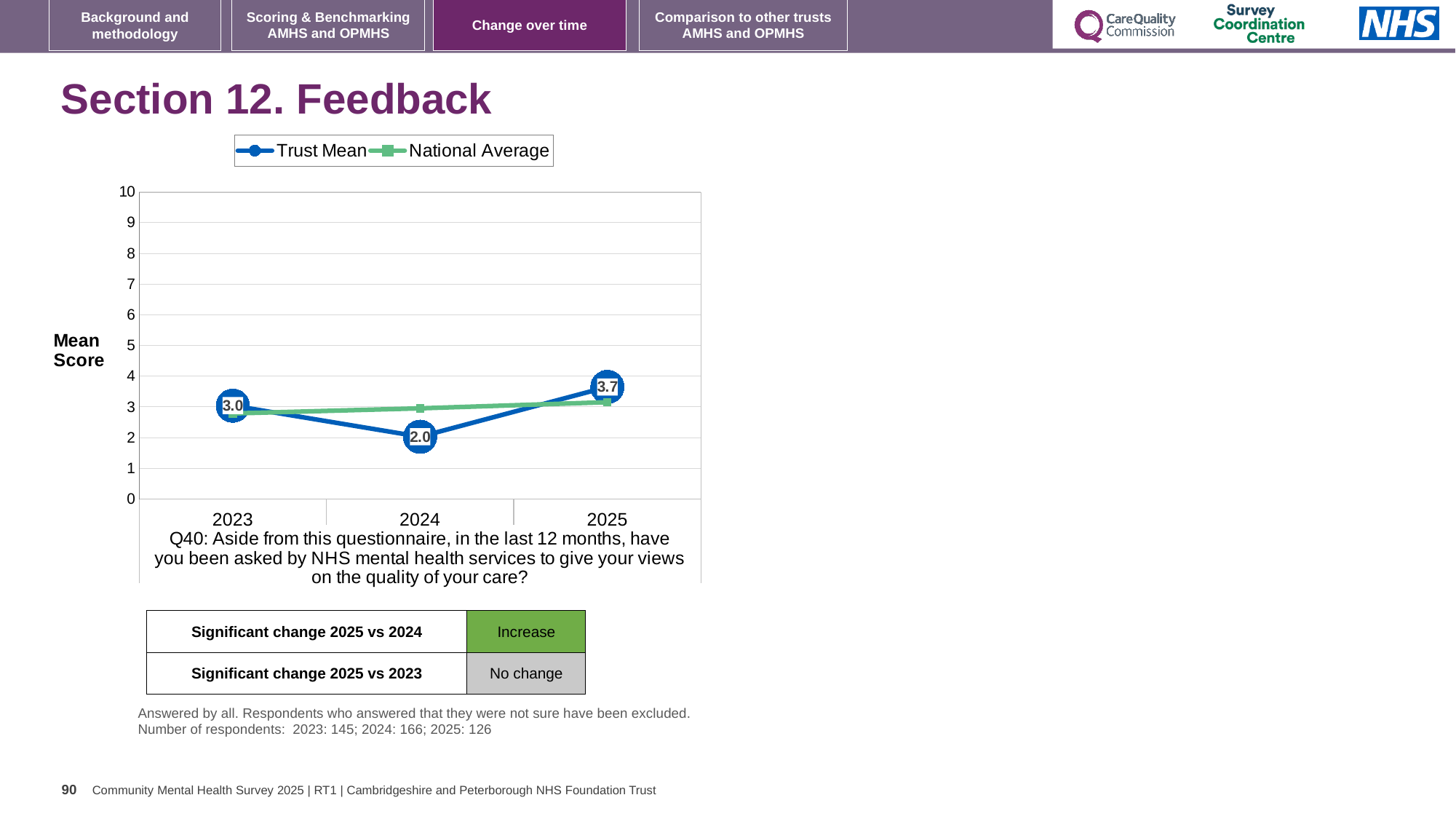
In which year is the Trust Mean highest? 2025 Which is larger, the Trust Mean in 2023 or in 2025? 2025 What is the Trust Mean score for 2023? 3.0 Is the National Average for 2024 greater or less than 5? less What is the Trust Mean score for 2025? 3.7 How many series does the legend list? 2 How many years are shown on the x axis? 3 What is the difference between the Trust Mean in 2025 and in 2024? 1.7 Does the Trust Mean rise or fall from 2024 to 2025? rise What is the Trust Mean score for 2024? 2.0 In which year is the Trust Mean lowest? 2024 What kind of chart is shown? line chart